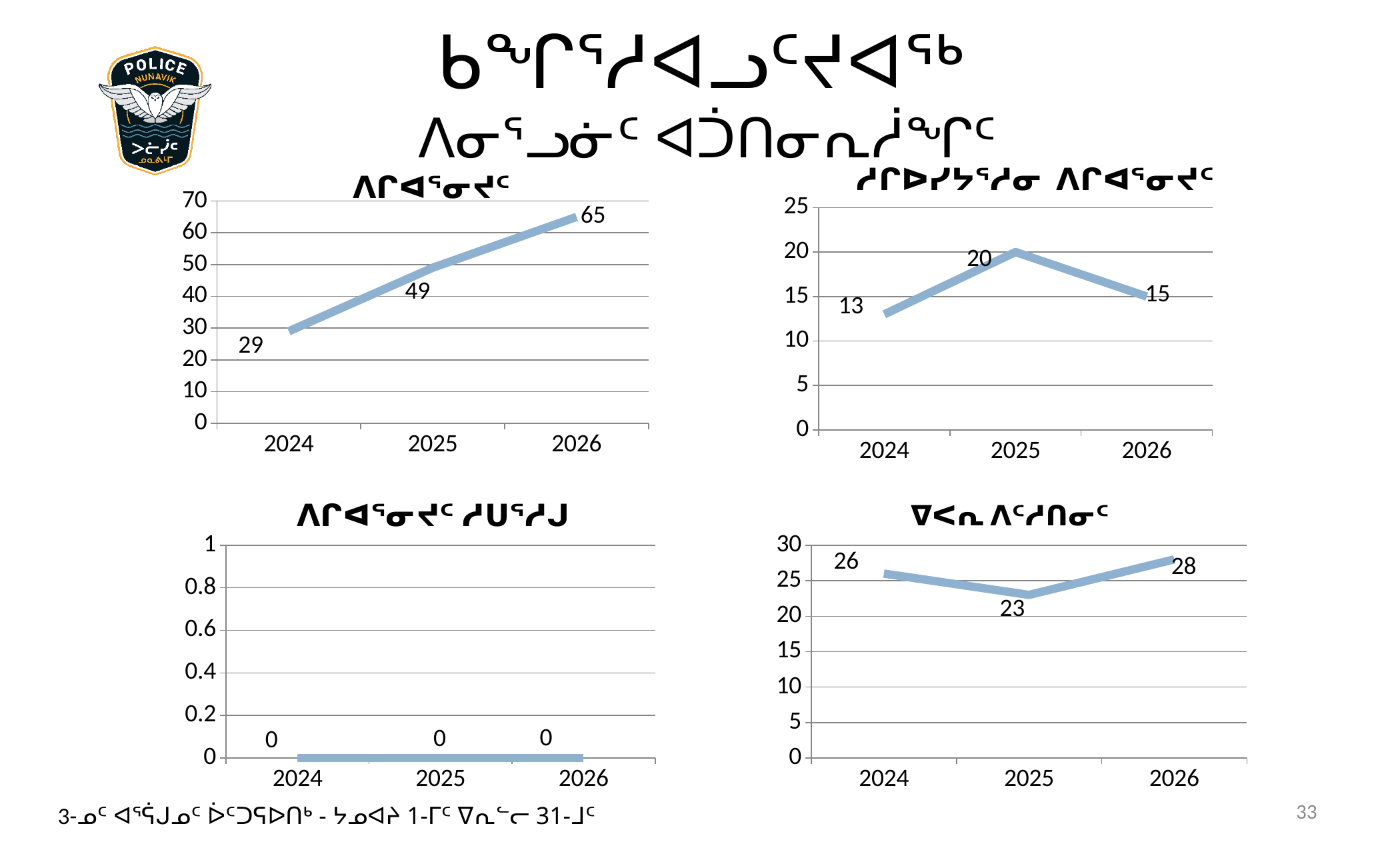
What kind of chart is the bottom-right chart? line chart In the bottom-right chart, what is the difference between the 2026 and 2025 values? 5 In the top-right chart, is the value for 2026 larger or smaller than the value for 2024? larger In the top-left chart, do the values rise or fall from 2024 to 2026? rise In the top-left chart, what is the value for 2025? 49 In the top-right chart, what is the value for 2025? 20 In the top-left chart, which year has the highest value? 2026 In the top-left chart, what is the difference between the 2026 and 2024 values? 36 In the bottom-right chart, what is the value for 2025? 23 In the bottom-left chart, what is the value for 2026? 0 How many years are plotted in the bottom-left chart? 3 In the top-right chart, which year has the lowest value? 2024